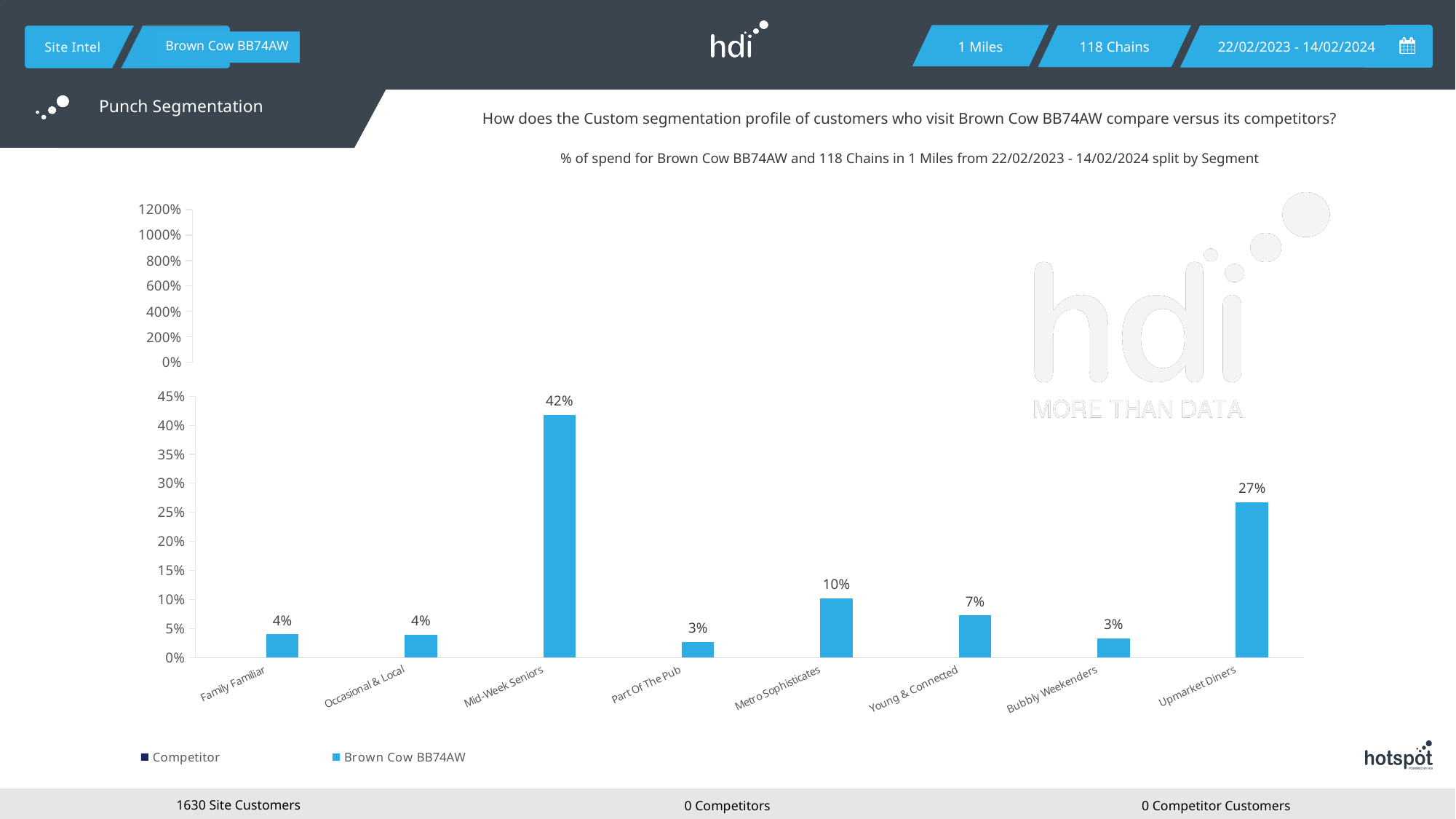
What is the % of spend for Brown Cow BB74AW in the Upmarket Diners segment? 27% How many segments are shown on the x axis of the chart? 8 What is the % of spend for Brown Cow BB74AW in the Mid-Week Seniors segment? 42% What is the % of spend for Brown Cow BB74AW in the Metro Sophisticates segment? 10% Which segment has a larger % of spend for Brown Cow BB74AW, Metro Sophisticates or Young & Connected? Metro Sophisticates What is the % of spend for Brown Cow BB74AW in the Young & Connected segment? 7% How many series does the legend list? 2 Which segment has the highest % of spend for Brown Cow BB74AW? Mid-Week Seniors Is the % of spend for Upmarket Diners greater or less than 25%? greater What are the two series named in the chart legend? Competitor and Brown Cow BB74AW What is the difference in % of spend between Mid-Week Seniors and Upmarket Diners for Brown Cow BB74AW? 15% What kind of chart is used to show the % of spend by segment? Bar chart